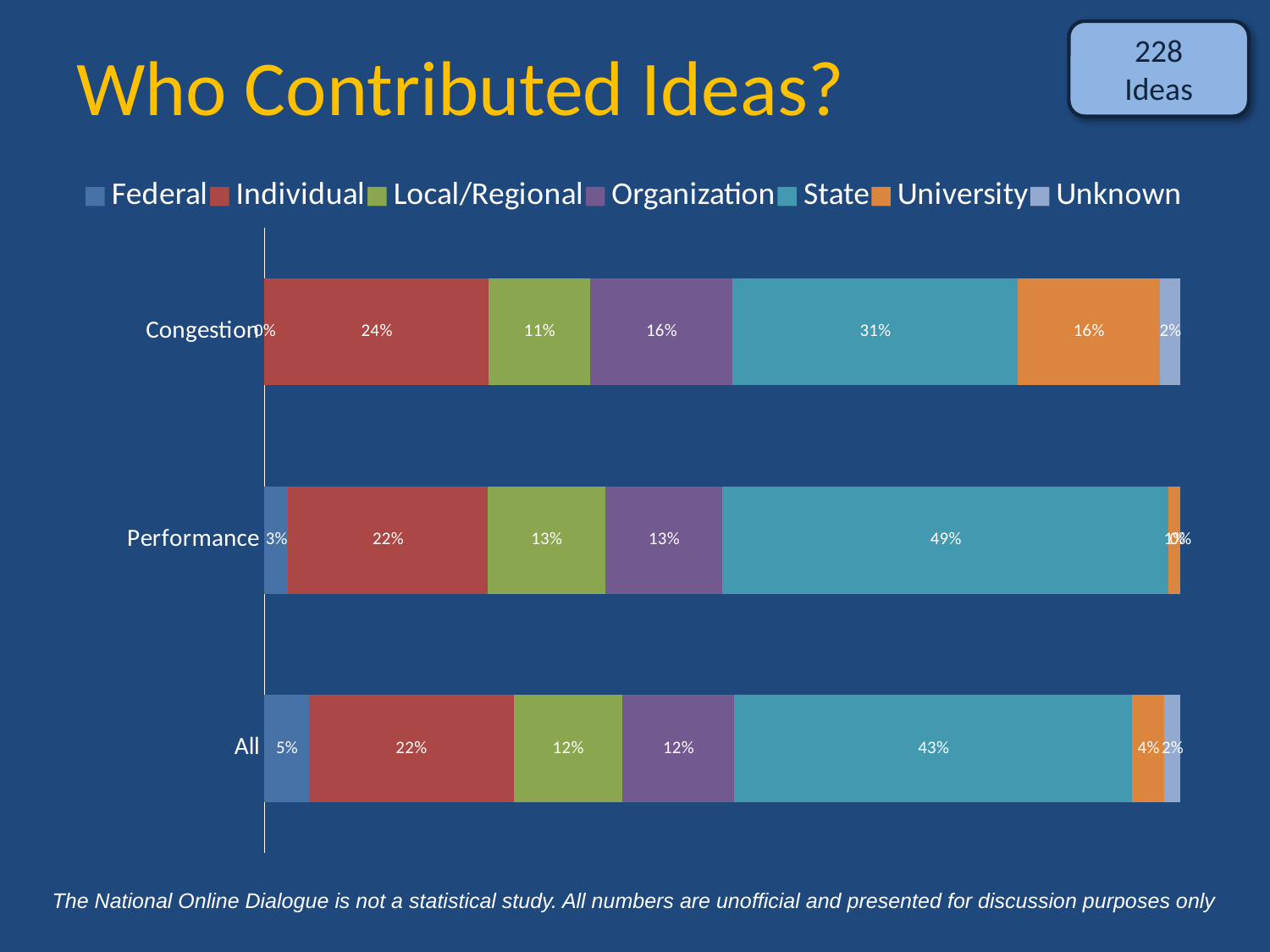
What is the title of the slide containing the chart? Who Contributed Ideas? What percentage of Congestion ideas came from the State series? 31% Which category has the highest State share? Performance What percentage of Performance ideas came from the State series? 49% How many series does the legend list? 7 What type of chart is shown on the slide? Stacked bar chart What is the difference between the State value for Performance and the State value for Congestion? 18% What is the University value for the Congestion bar? 16% Which is larger for the Congestion bar: the Individual value or the Organization value? Individual How many categories (bars) are shown in the chart? 3 What is the Individual value for the All bar? 22% What is the Federal value for the All bar? 5%